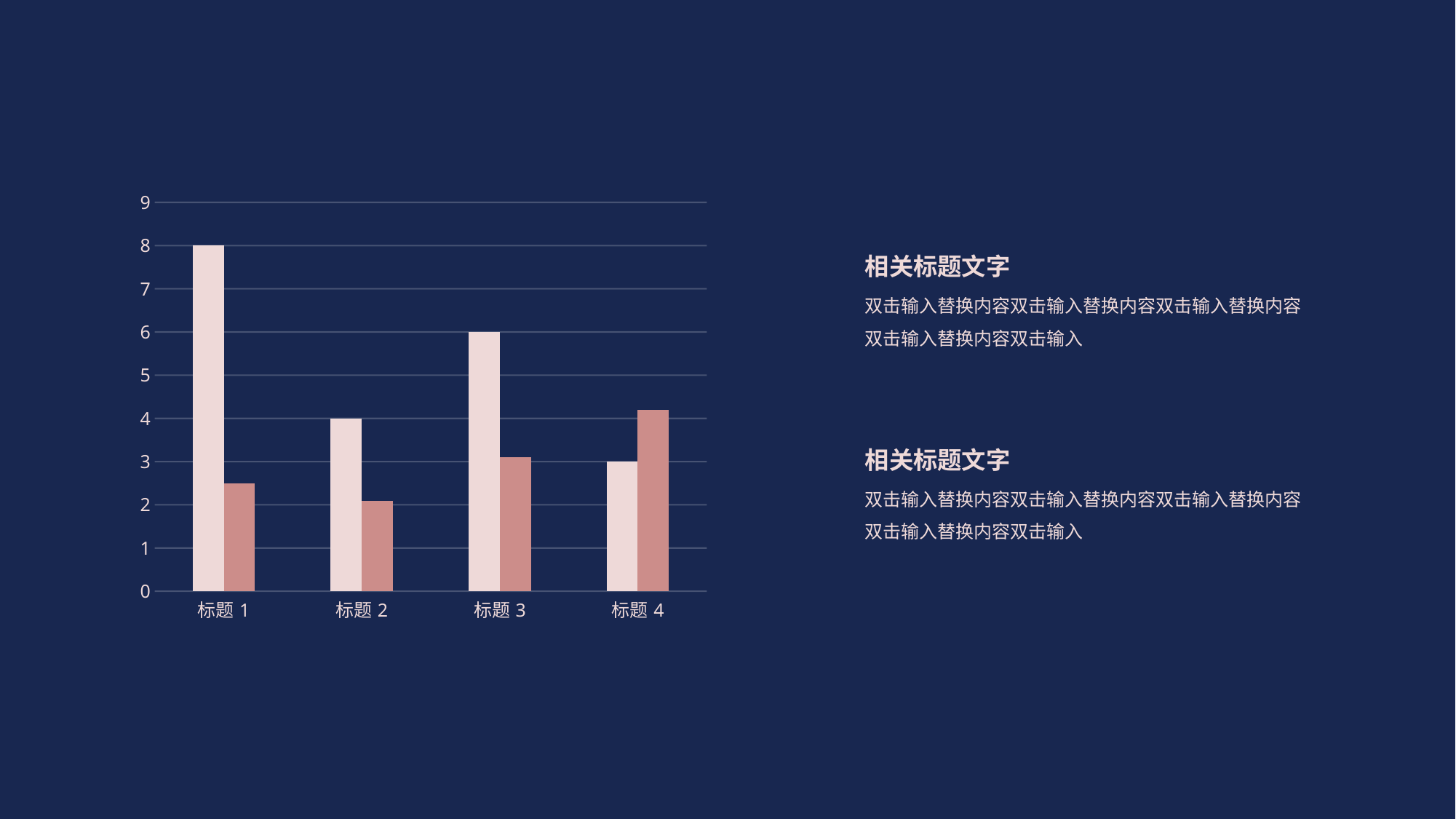
Is the value of the darker bar for 标题 4 greater or less than 4? greater Which has the larger lighter bar, 标题 2 or 标题 3? 标题 3 How many categories are shown on the x axis of the chart? 4 Which category has the shortest lighter bar? 标题 4 Which category has the tallest darker bar? 标题 4 What is the value of the lighter bar for 标题 3? 6 What is the value of the lighter bar for 标题 1? 8 What is the difference between the lighter bars for 标题 1 and 标题 2? 4 What kind of chart is shown on the slide? bar chart For 标题 4, which bar is taller, the lighter one or the darker one? the darker one Is the value of the darker bar for 标题 1 greater or less than 3? less Which category has the tallest lighter bar? 标题 1